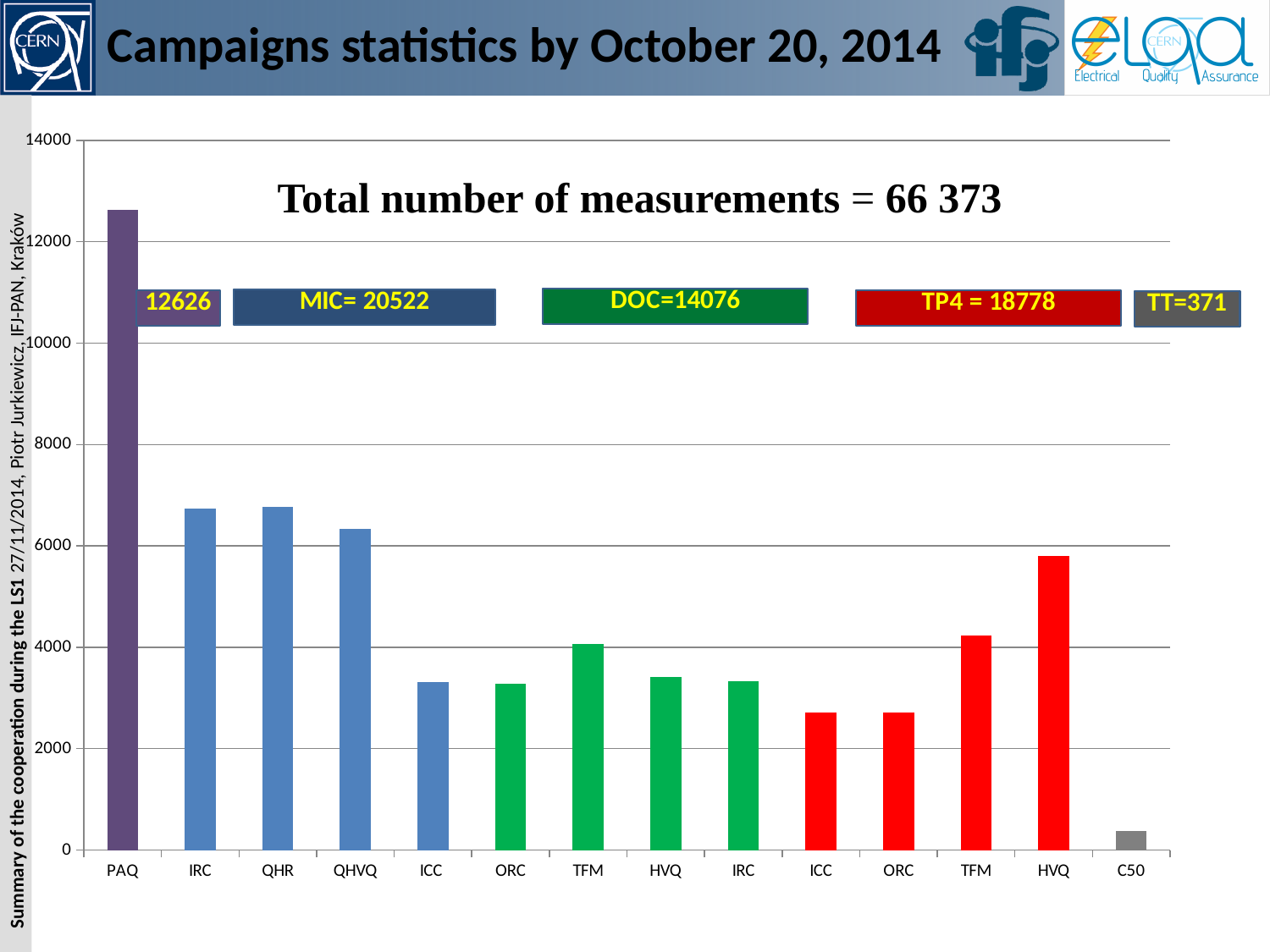
What total number of measurements is stated on the chart? 66 373 Which category has the lowest bar in the chart? C50 Is the value for the red ICC bar greater or less than 3000? less How many bars are plotted in the chart? 14 Which category has the highest bar in the chart? PAQ What kind of chart is shown on the slide? bar chart Which is larger, the red HVQ bar or the green HVQ bar? the red HVQ bar Is the value for the blue IRC bar greater or less than 6000? greater What value is given for TP4 in the label box on the chart? 18778 Which is larger, the QHR bar or the blue ICC bar? QHR What value is labelled for the PAQ bar? 12626 Is the value for the red HVQ bar greater or less than 6000? less